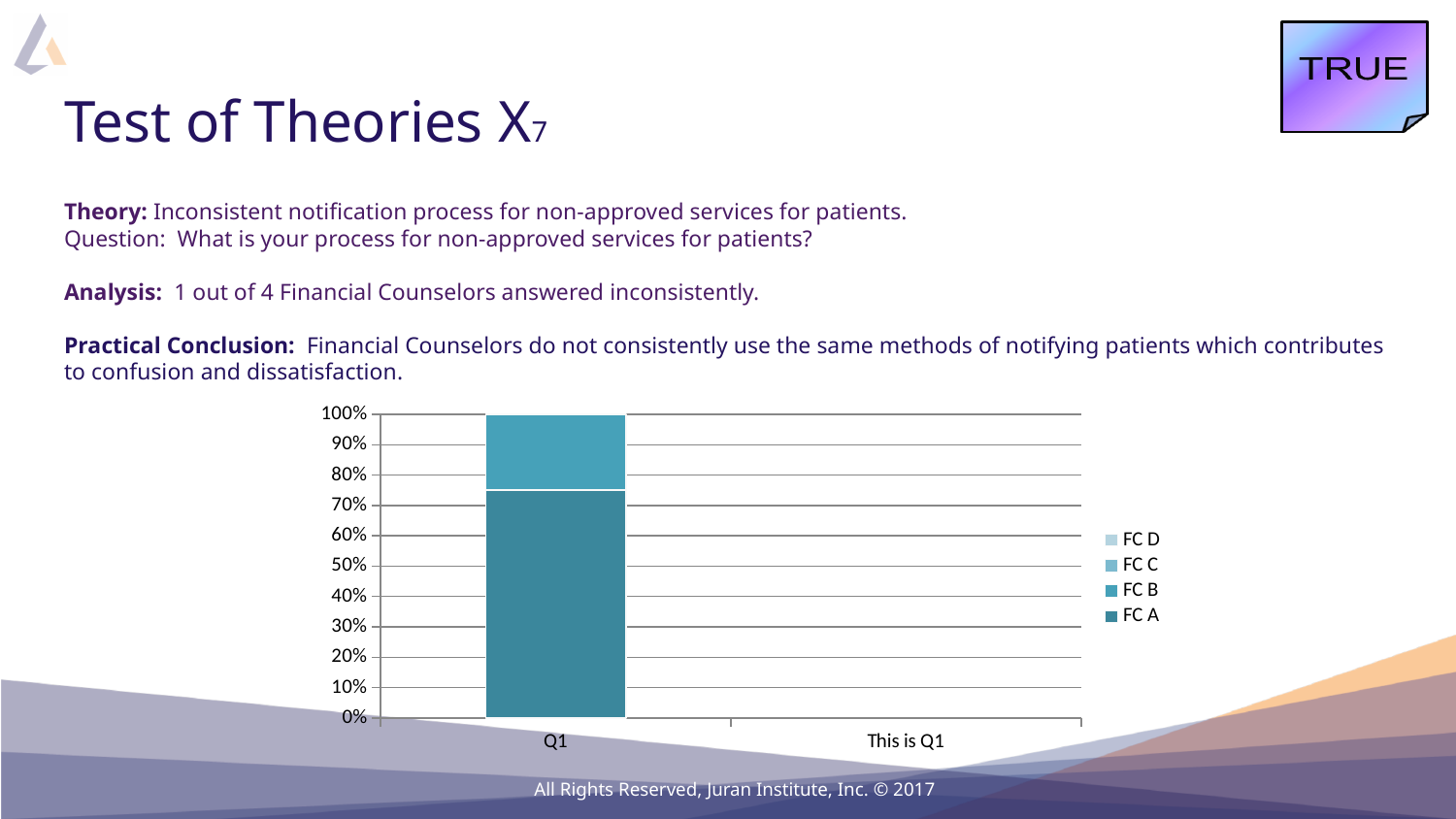
What are the category labels on the x axis of the chart? Q1 and This is Q1 What is the highest value shown on the y axis of the chart? 100% Which x-axis category has a bar plotted, Q1 or This is Q1? Q1 What kind of chart is shown on the slide? bar chart Is the bottom (darker) segment of the Q1 bar greater or less than 70%? greater How many series does the chart's legend list? 4 What is the total height of the stacked bar for Q1? 100% Which series is listed first (at the top) in the chart's legend? FC D Is the bottom (darker) segment of the Q1 bar greater or less than 80%? less Which segment of the Q1 bar is larger, the bottom darker segment or the top lighter segment? the bottom darker segment Is the top (lighter) segment of the Q1 bar greater or less than 30%? less How many category labels appear on the x axis of the chart? 2